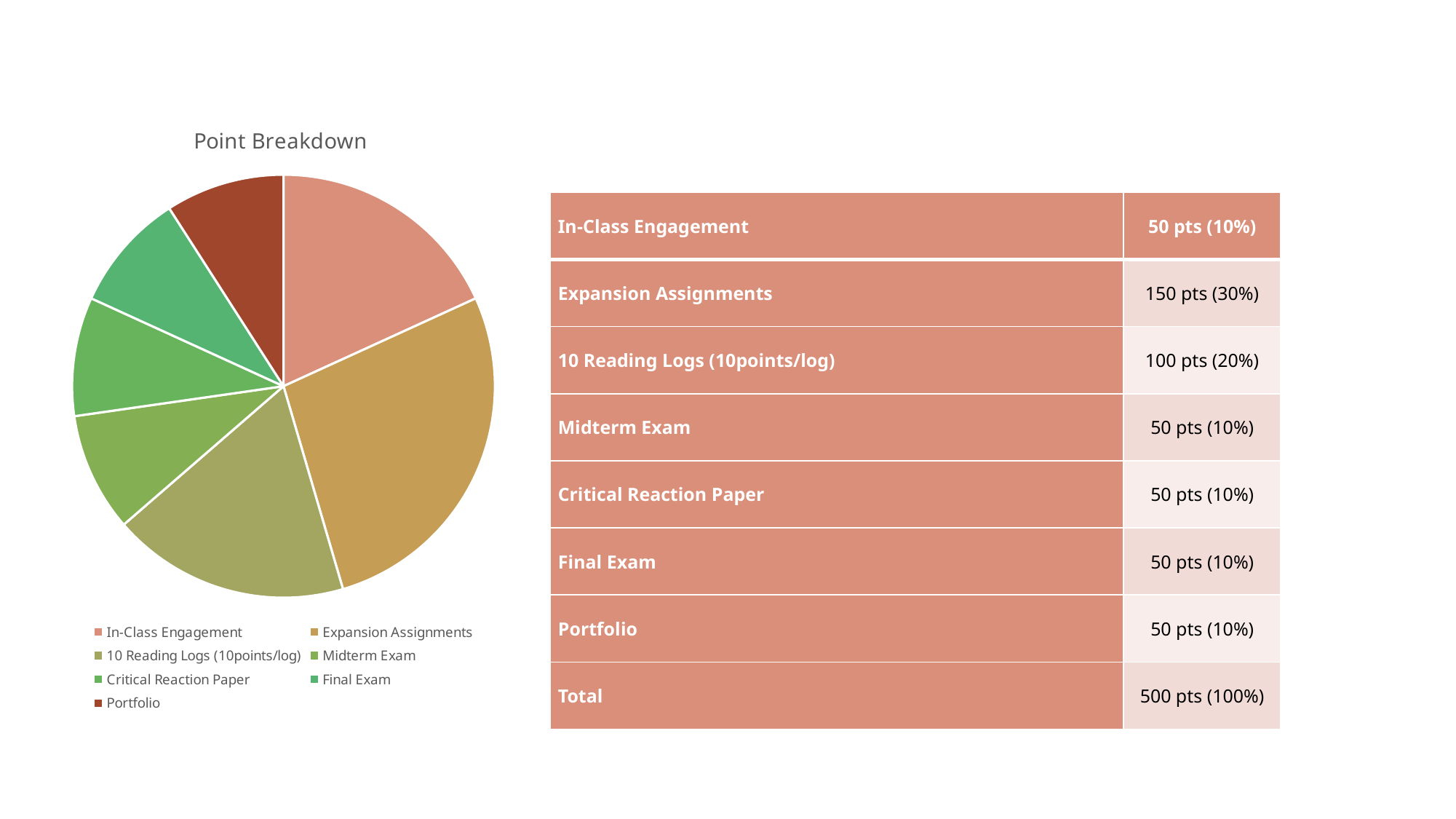
How many entries does the legend of the Point Breakdown pie chart list? 7 Which is larger in the Point Breakdown pie chart: the Expansion Assignments slice or the In-Class Engagement slice? Expansion Assignments According to the table, how many points is the Midterm Exam worth? 50 pts What is the total number of points shown in the table? 500 pts What is the title of the pie chart? Point Breakdown According to the table, how many points are the 10 Reading Logs worth? 100 pts Which is larger in the Point Breakdown pie chart: the 10 Reading Logs (10points/log) slice or the Portfolio slice? 10 Reading Logs (10points/log) Which category has the largest slice in the Point Breakdown pie chart? Expansion Assignments How many slices does the Point Breakdown pie chart have? 7 According to the table, what share of the total points do Expansion Assignments represent? 30% What is the difference in points between Expansion Assignments and the Final Exam according to the table? 100 pts What kind of chart is shown on the slide? pie chart